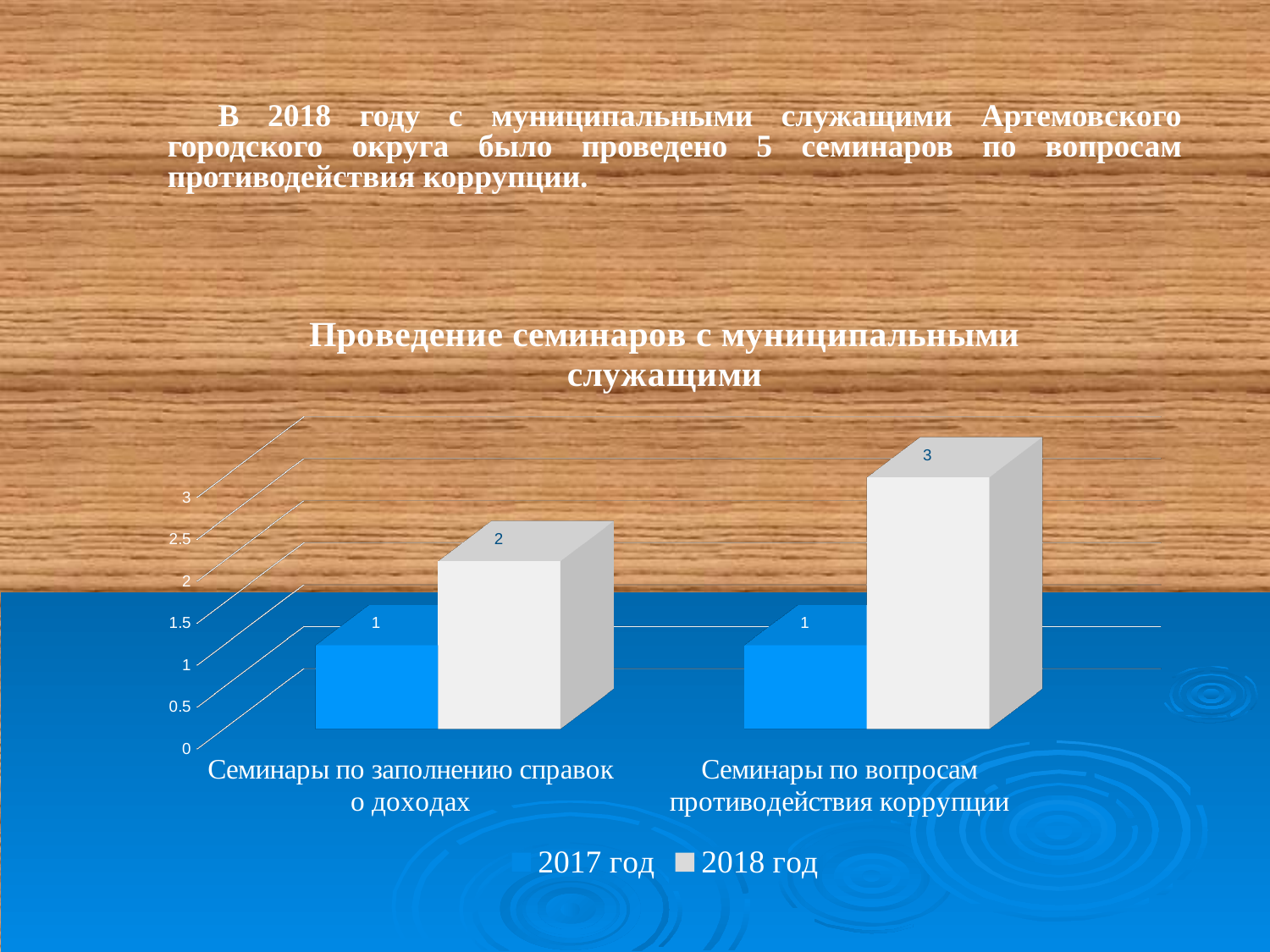
What is the title of the chart? Проведение семинаров с муниципальными служащими What is the difference between the 2018 год and 2017 год values for Семинары по вопросам противодействия коррупции? 2 What is the value for 2018 год for Семинары по вопросам противодействия коррупции? 3 What is the value for 2017 год for Семинары по заполнению справок о доходах? 1 Which category has the highest value for 2018 год? Семинары по вопросам противодействия коррупции Which is larger for Семинары по заполнению справок о доходах: the 2017 год value or the 2018 год value? 2018 год What kind of chart is shown on the slide? bar chart How many categories are shown on the x axis? 2 What is the value for 2018 год for Семинары по заполнению справок о доходах? 2 How many series does the legend list? 2 What is the value for 2017 год for Семинары по вопросам противодействия коррупции? 1 What is the difference between the 2018 год values for Семинары по вопросам противодействия коррупции and Семинары по заполнению справок о доходах? 1